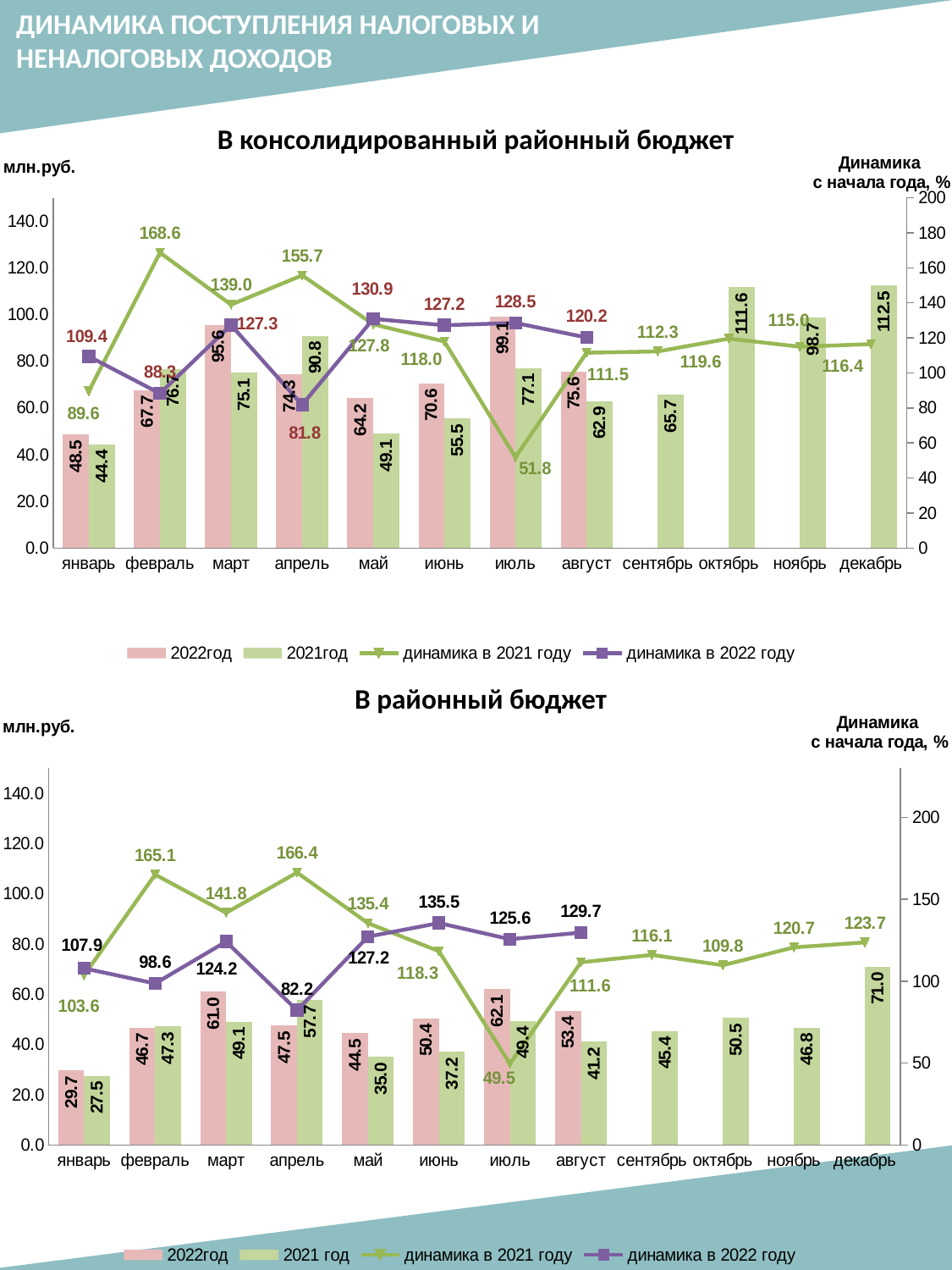
In the chart 'В консолидированный районный бюджет', what is the value of the 2022год bar for июль? 99.1 In the chart 'В районный бюджет', which is larger for апрель: the 2022год bar or the 2021 год bar? 2021 год In the chart 'В районный бюджет', what is the value of the 'динамика в 2022 году' line for июнь? 135.5 In the chart 'В консолидированный районный бюджет', what is the difference between the 2022год and 2021год bars for март? 20.5 In the chart 'В консолидированный районный бюджет', which month has the lowest value on the 'динамика в 2021 году' line? июль In the chart 'В районный бюджет', how many months have a 2022год bar? 8 In the chart 'В районный бюджет', what is the difference between the 2022год and 2021 год bars for июль? 12.7 In the chart 'В районный бюджет', which month has the highest 2021 год bar? декабрь In the chart 'В консолидированный районный бюджет', which month has the highest value on the 'динамика в 2021 году' line? февраль What is the title of the top chart on the slide? В консолидированный районный бюджет In the chart 'В консолидированный районный бюджет', what is the value of the 2021год bar for декабрь? 112.5 In the chart 'В консолидированный районный бюджет', how many series does the legend list? 4